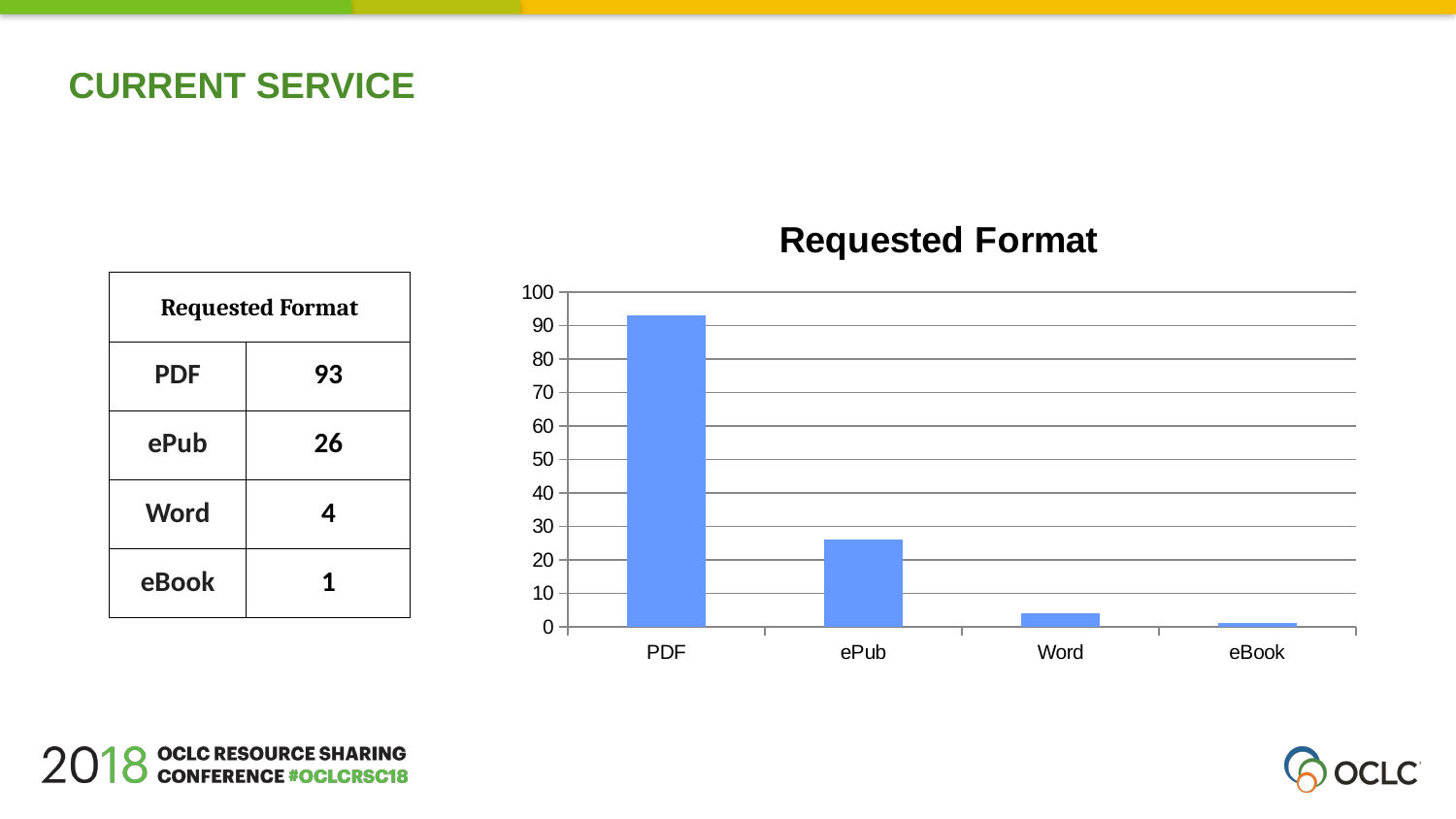
Is the value for PDF greater or less than 90? greater Which requested format has the highest value? PDF What is the difference between the values for PDF and ePub? 67 What is the value for ePub? 26 What type of chart is shown on the slide? bar chart Do the values rise or fall from left to right along the x axis? fall What is the title of the chart? Requested Format What is the value for PDF? 93 Which requested format has the lowest value? eBook How many categories are shown on the x axis of the chart? 4 Which is larger, the value for ePub or the value for Word? ePub What is the value for Word? 4